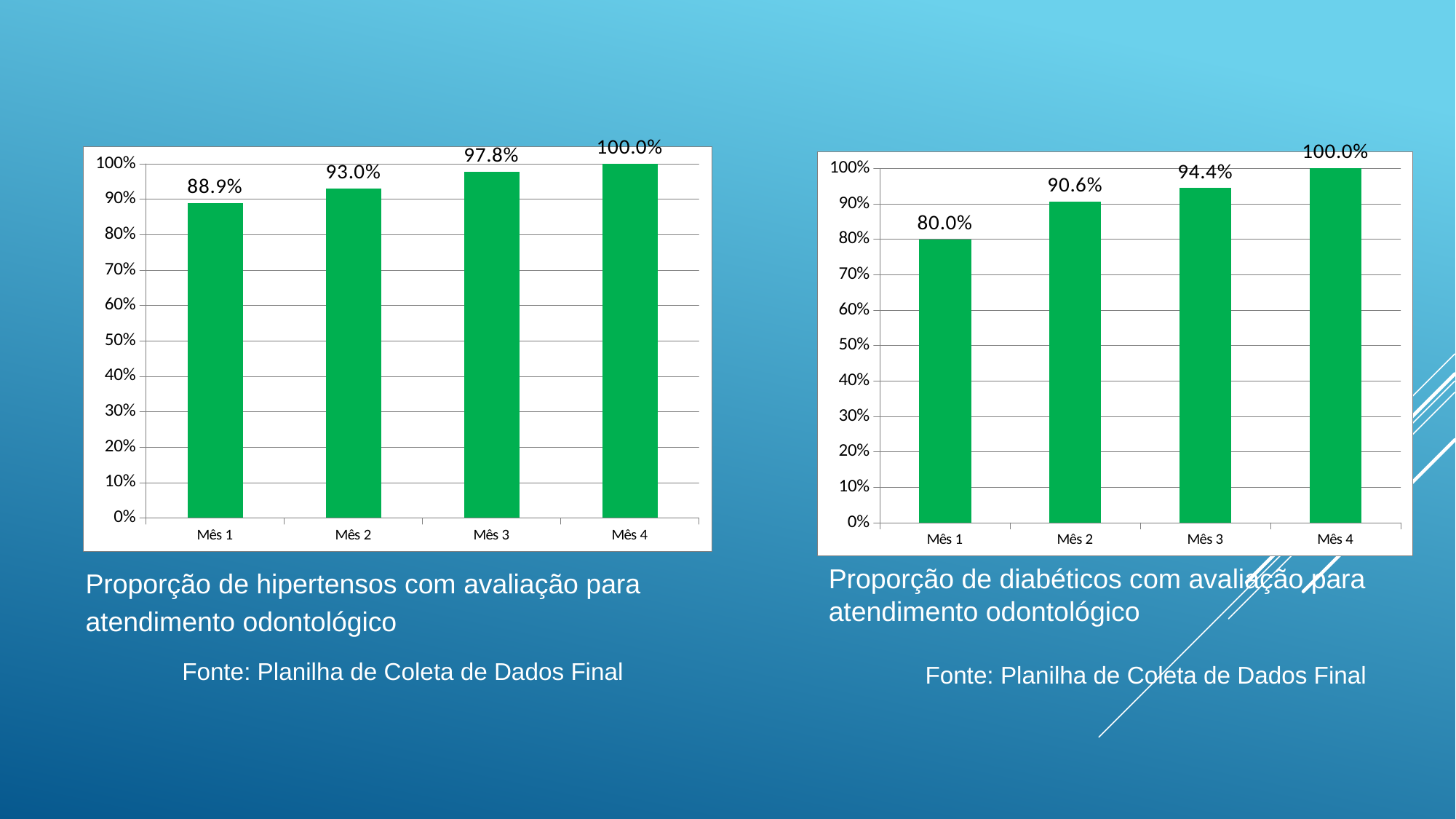
In the right chart (Proporção de diabéticos com avaliação para atendimento odontológico), what is the difference between the values for Mês 3 and Mês 2? 3.8% In the right chart (Proporção de diabéticos com avaliação para atendimento odontológico), what is the value for Mês 1? 80.0% In the left chart (Proporção de hipertensos com avaliação para atendimento odontológico), which month has the lowest value? Mês 1 In the right chart (Proporção de diabéticos com avaliação para atendimento odontológico), do the values rise or fall from Mês 1 to Mês 4? Rise In the right chart (Proporção de diabéticos com avaliação para atendimento odontológico), which month has the highest value? Mês 4 In the right chart (Proporção de diabéticos com avaliação para atendimento odontológico), what is the value for Mês 2? 90.6% In the left chart (Proporção de hipertensos com avaliação para atendimento odontológico), what is the difference between the values for Mês 4 and Mês 1? 11.1% In the left chart (Proporção de hipertensos com avaliação para atendimento odontológico), what is the value for Mês 1? 88.9% How many months are shown on the x axis of the right chart (Proporção de diabéticos com avaliação para atendimento odontológico)? 4 In the left chart (Proporção de hipertensos com avaliação para atendimento odontológico), what is the value for Mês 3? 97.8% Which is larger: the Mês 2 value in the left chart (hipertensos) or the Mês 2 value in the right chart (diabéticos)? Left chart (hipertensos), 93.0% What kind of chart is the left chart (Proporção de hipertensos com avaliação para atendimento odontológico)? Bar chart